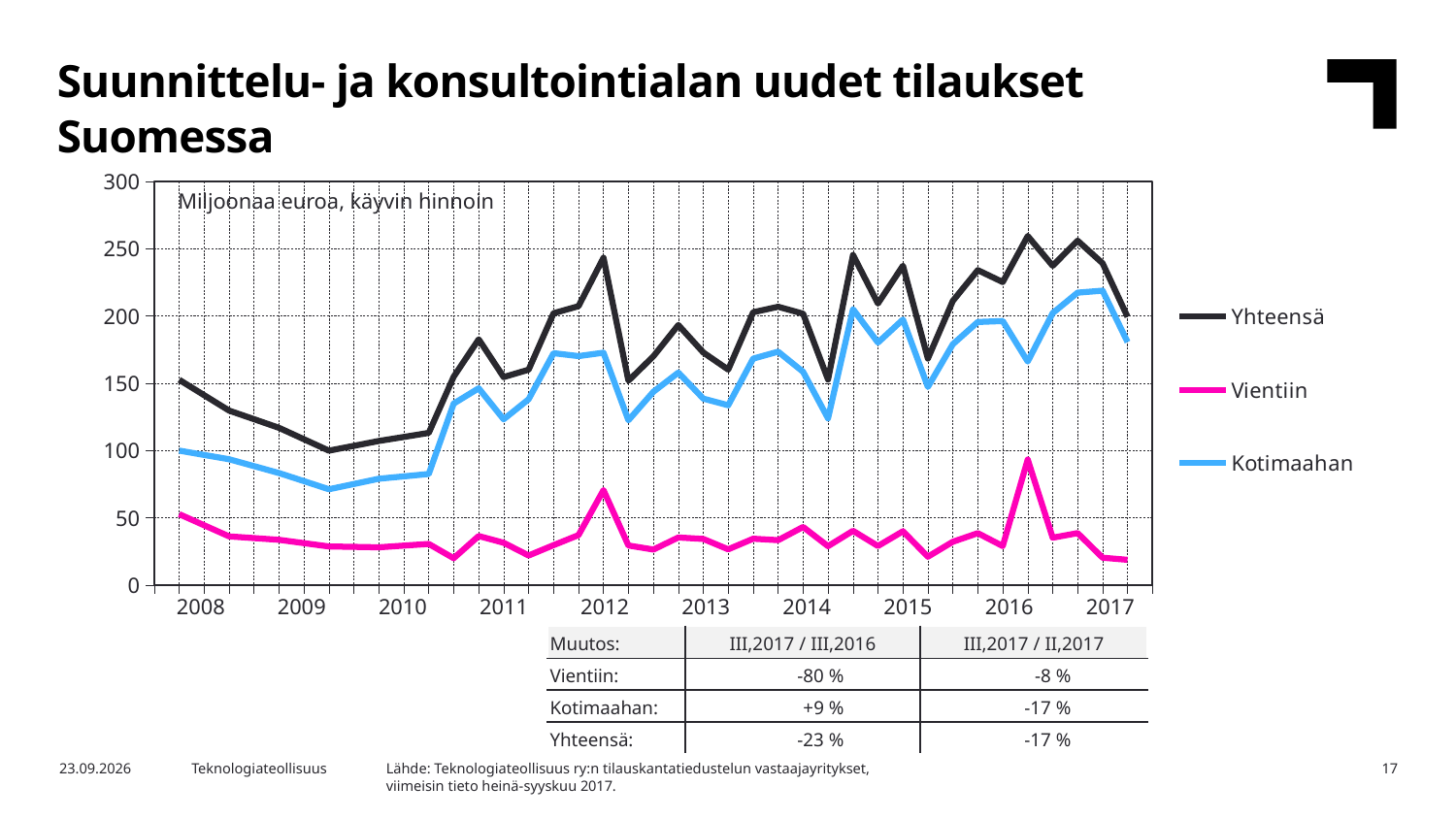
What kind of chart is shown on the slide? line chart Which series are listed in the legend? Yhteensä, Vientiin, Kotimaahan Does the Vientiin series overall rise or fall from 2008 to 2017? fall Is the peak value of the Yhteensä series in 2016 greater or less than 250? greater Which series has the highest values throughout the whole period? Yhteensä Is the lowest value of the Kotimaahan series in 2009 greater or less than 100? less Is the highest value of the Vientiin series greater or less than 100? less How many series does the legend list? 3 What unit is stated inside the chart area? Miljoonaa euroa, käyvin hinnoin Which series has the lowest values throughout the whole period? Vientiin Which series is larger in 2015, Kotimaahan or Vientiin? Kotimaahan How many years are labelled on the x axis? 10